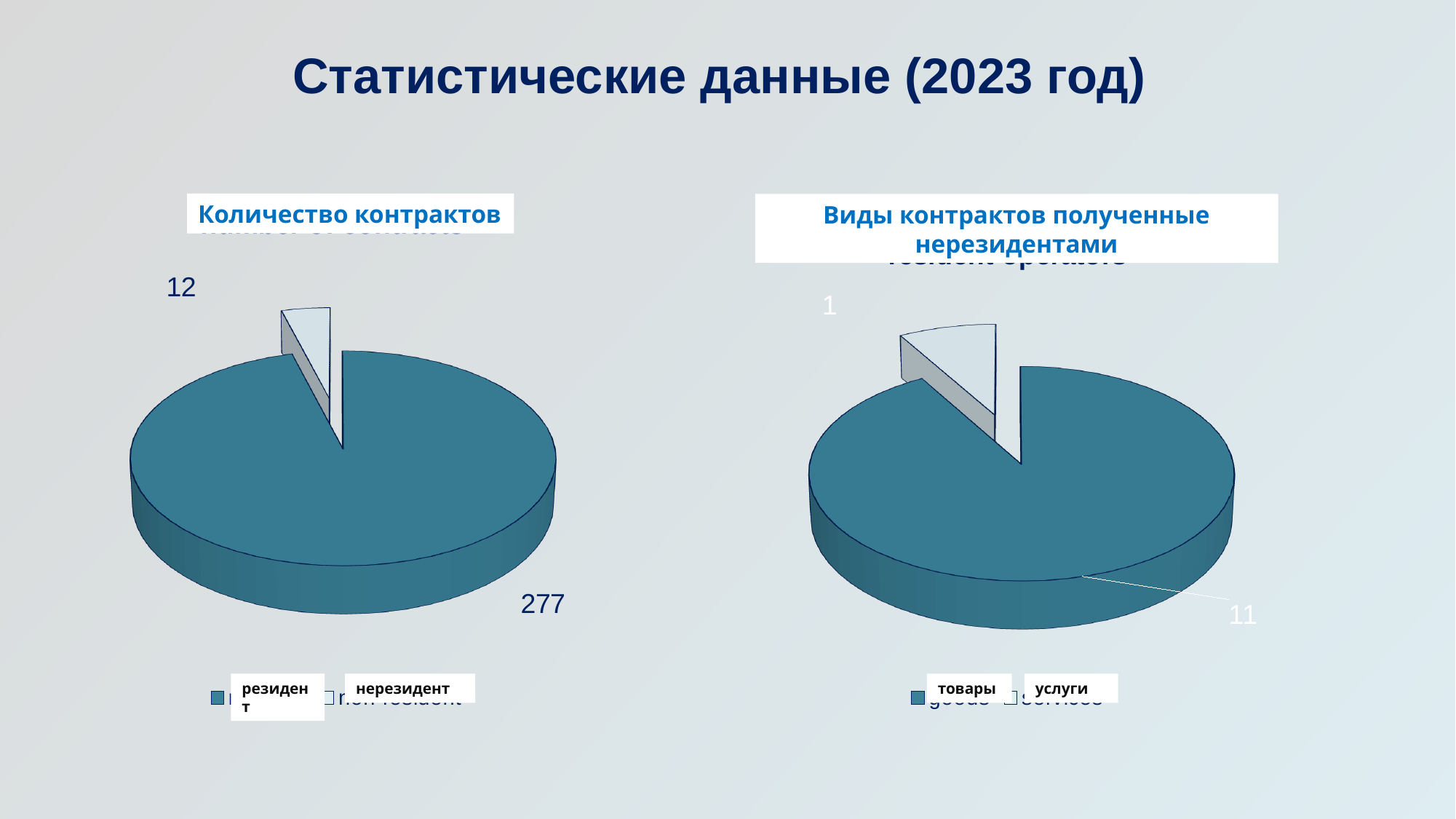
In the chart titled "Виды контрактов полученные нерезидентами", which category has the smallest slice? услуги In the chart titled "Количество контрактов", which category has the largest slice? резидент What is the title of the chart on the right of the slide? Виды контрактов полученные нерезидентами How many categories does the chart titled "Количество контрактов" show? 2 In the chart titled "Виды контрактов полученные нерезидентами", what is the difference between the values for товары and услуги? 10 In the chart titled "Количество контрактов", what is the difference between the values for резидент and нерезидент? 265 In the chart titled "Количество контрактов", what is the value for нерезидент? 12 In the chart titled "Количество контрактов", what is the value for резидент? 277 What kind of chart is the chart on the left of the slide? Pie chart In the chart titled "Виды контрактов полученные нерезидентами", what is the value for товары? 11 In the chart titled "Виды контрактов полученные нерезидентами", what is the value for услуги? 1 In the chart titled "Виды контрактов полученные нерезидентами", which is larger, товары or услуги? товары